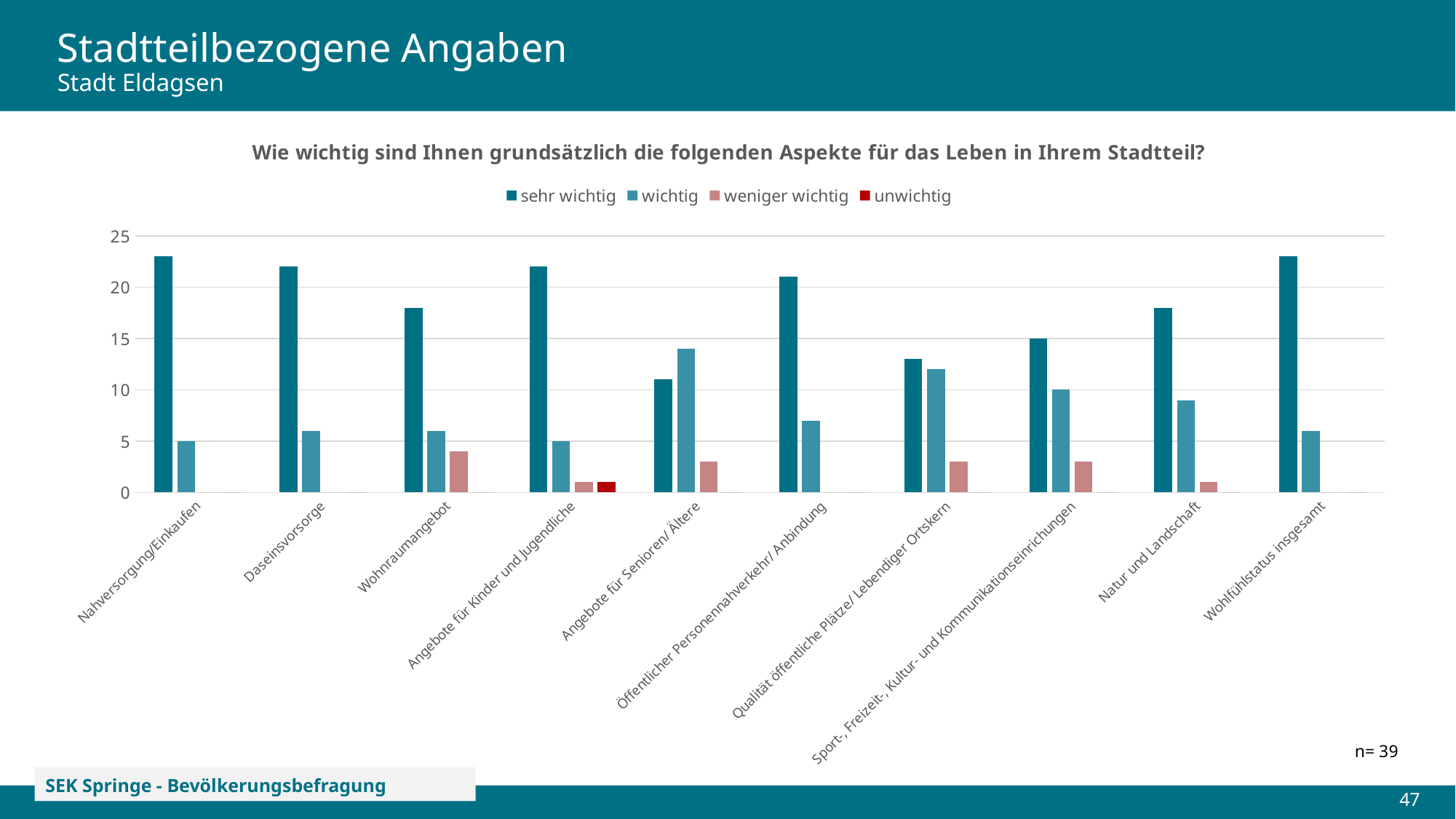
What sample size (n) is stated on the slide? n= 39 Is the value of 'sehr wichtig' for 'Angebote für Senioren/ Ältere' greater or less than 15? less What kind of chart is shown on the slide? bar chart Is the value of 'sehr wichtig' for 'Wohlfühlstatus insgesamt' greater or less than 20? greater How many series does the legend list? 4 How many categories are shown on the x axis? 10 What is the value of 'wichtig' for 'Nahversorgung/Einkaufen'? 5 What is the value of 'sehr wichtig' for 'Sport-, Freizeit-, Kultur- und Kommunikationseinrichtungen'? 15 Which category has the lowest 'sehr wichtig' value? Angebote für Senioren/ Ältere For 'Angebote für Senioren/ Ältere', which is larger: 'sehr wichtig' or 'wichtig'? wichtig Is the value of 'sehr wichtig' for 'Nahversorgung/Einkaufen' greater or less than 20? greater Which category is the only one with a visible 'unwichtig' bar? Angebote für Kinder und Jugendliche